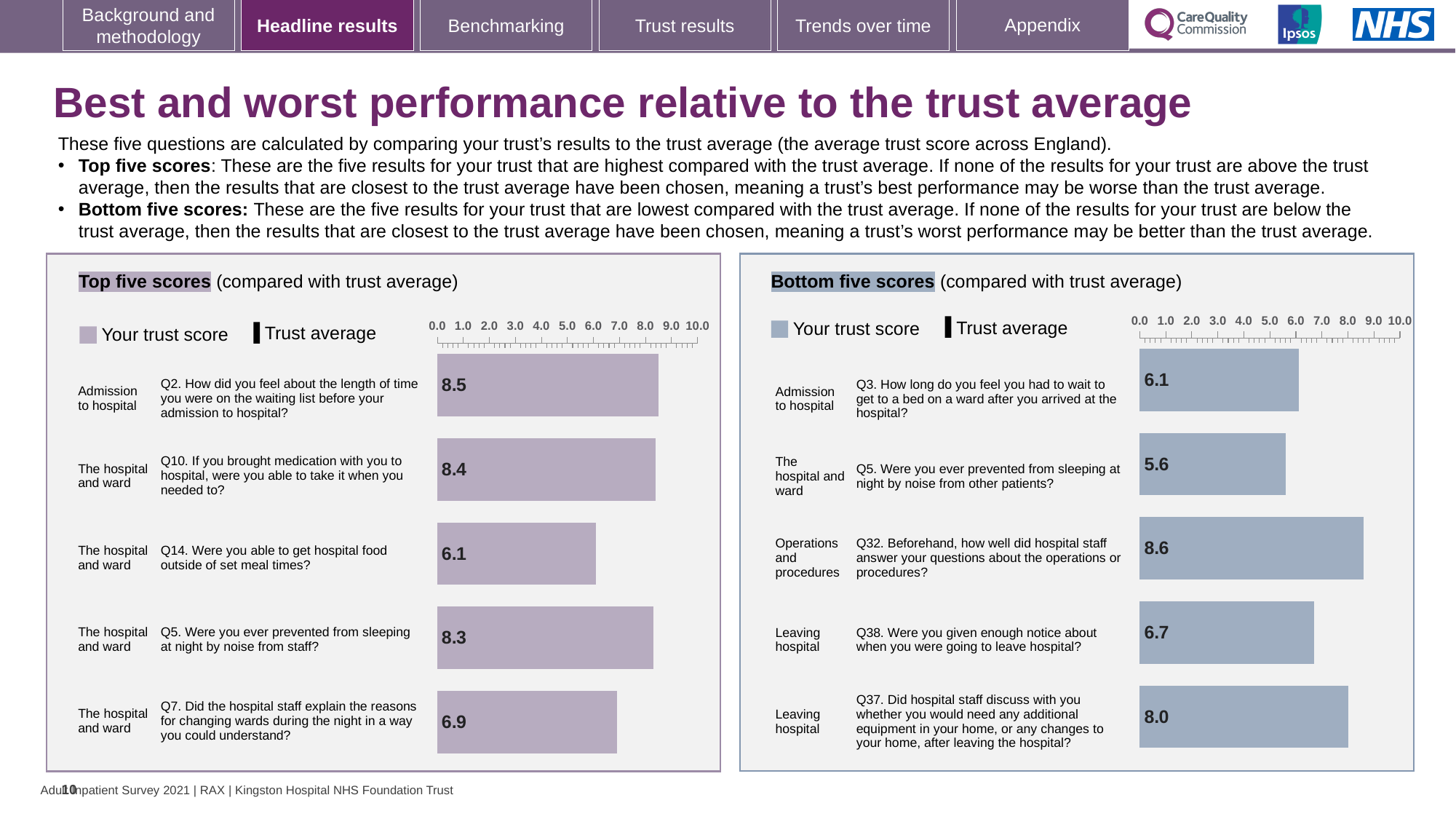
In the Top five scores chart, what is the trust score for Q2 about the length of time on the waiting list before admission? 8.5 In the Top five scores chart, which question has the lowest trust score? Q14 How many questions are shown in the Bottom five scores chart? 5 In the Bottom five scores chart, which question has the lowest trust score? Q5 In the Top five scores chart, what is the trust score for Q14 about getting hospital food outside of set meal times? 6.1 In the Top five scores chart, what is the difference between the scores for Q2 and Q14? 2.4 In the Bottom five scores chart, which question has the highest trust score? Q32 In the Bottom five scores chart, what is the trust score for Q37 about staff discussing additional equipment or changes to your home? 8.0 What kind of chart is used in the Top five scores panel? Bar chart In the Bottom five scores chart, what is the trust score for Q5 about being prevented from sleeping at night by noise from other patients? 5.6 In the Top five scores chart, which has the higher score: Q5 about noise from staff or Q7 about explaining ward changes at night? Q5 In the Bottom five scores chart, what is the difference between the scores for Q32 and Q5? 3.0